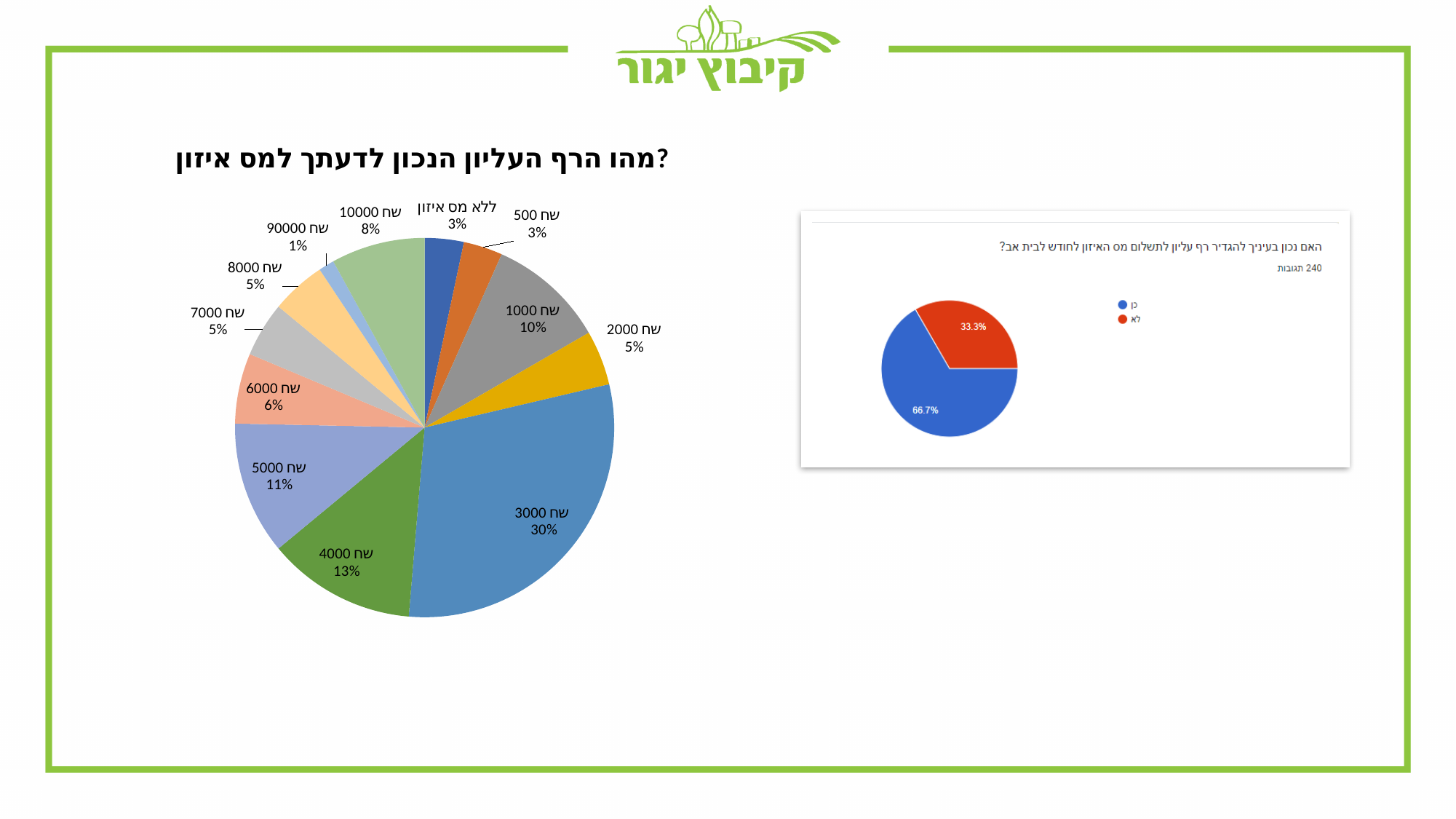
How many slices does the left pie chart have? 12 In the right pie chart, what percentage of respondents answered כן? 66.7% In the left pie chart, which category has the smallest slice? 90000 שח How many entries does the legend of the right pie chart list? 2 In the left pie chart, what share of responses chose 5000 שח? 11% In the left pie chart, what is the difference in percentage points between the 3000 שח slice and the 4000 שח slice? 17 In the left pie chart, which slice is larger: 1000 שח or 2000 שח? 1000 שח What type of chart is shown on the left of the slide? Pie chart How many responses (תגובות) does the right chart report? 240 In the right pie chart, what percentage of respondents answered לא? 33.3% In the left pie chart, what share of responses chose 3000 שח? 30% In the left pie chart, which category has the largest slice? 3000 שח